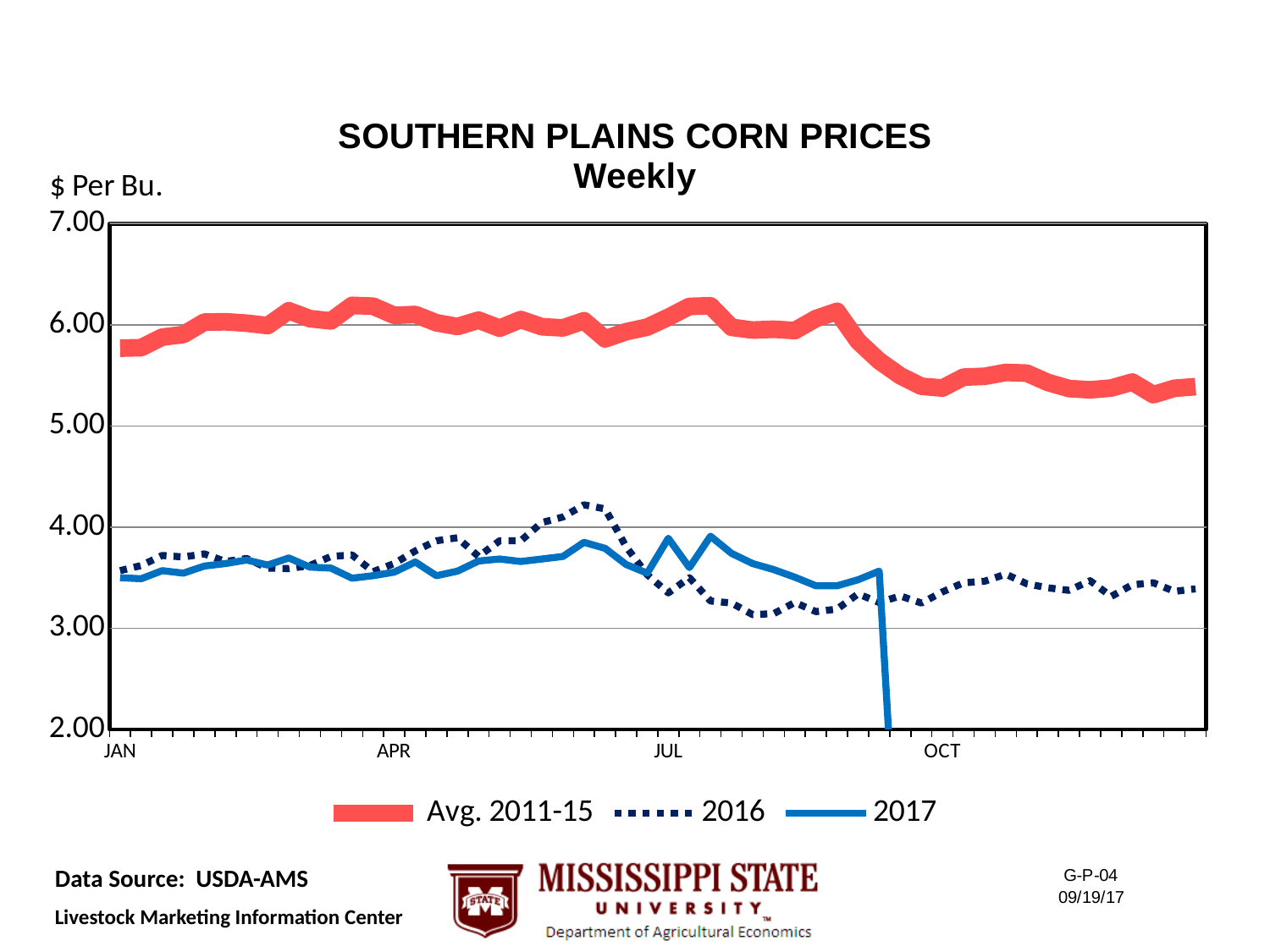
What are the three series listed in the legend? Avg. 2011-15, 2016, 2017 Is the value of the Avg. 2011-15 series at JAN greater or less than 5.00? greater Is the value of the 2016 series at JAN greater or less than 4.00? less Is the value of the Avg. 2011-15 series at OCT greater or less than 6.00? less At APR, which series is higher: Avg. 2011-15 or 2016? Avg. 2011-15 How many series does the legend list? 3 At JAN, which series is higher: Avg. 2011-15 or 2017? Avg. 2011-15 What unit label is shown above the vertical axis? $ Per Bu. Does the Avg. 2011-15 series rise or fall overall from JAN to the end of the year? fall What kind of chart is shown on the slide? line chart